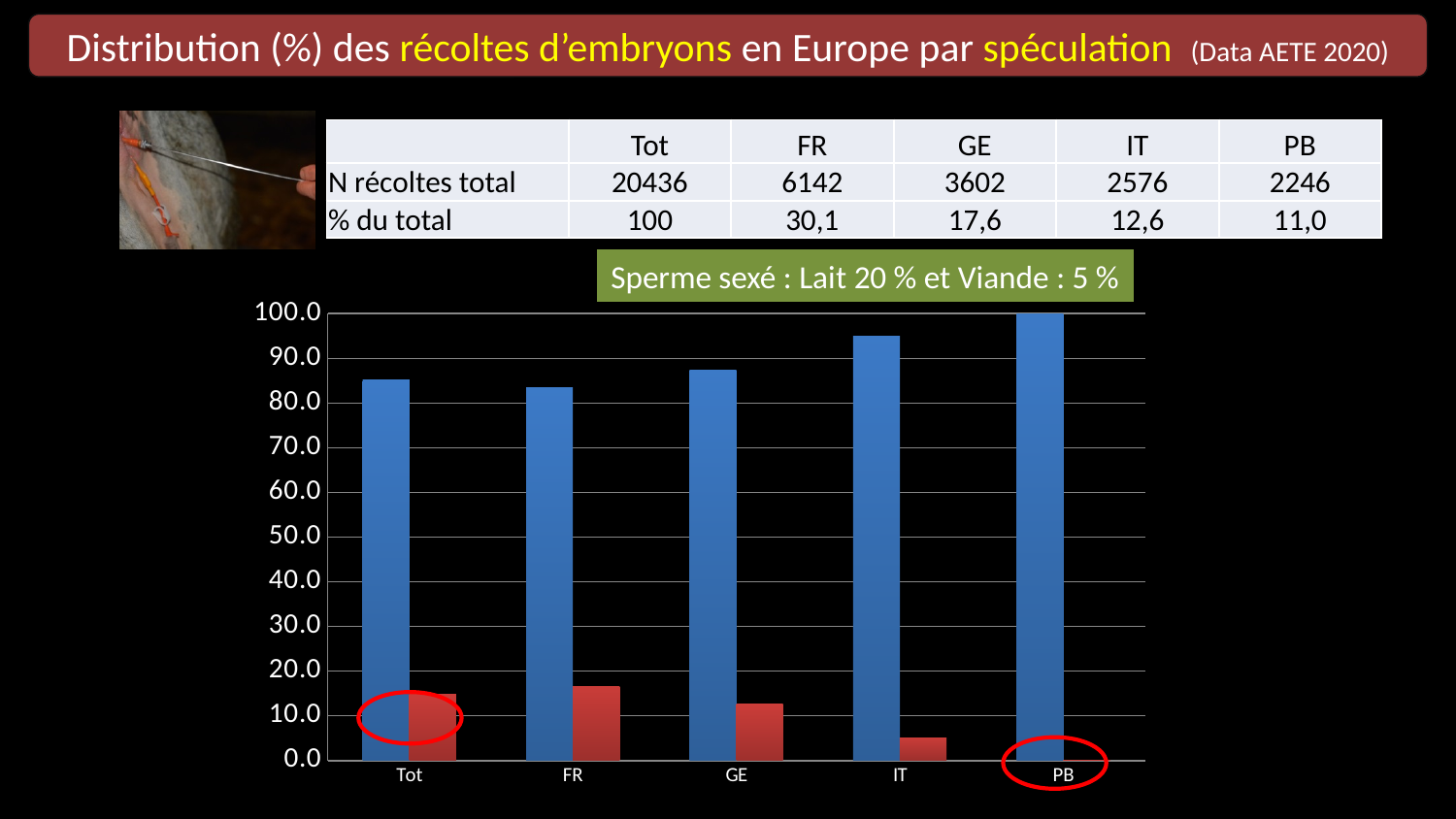
Is the red bar for FR greater or less than 20.0? less What is the highest value shown on the y axis of the chart? 100.0 Which is larger, the blue bar for IT or the blue bar for GE? IT How many categories are shown on the x axis of the chart? 5 Do the red bars rise or fall from FR to PB along the x axis? fall Which category has the tallest blue bar? PB What kind of chart is shown on the slide? bar chart Is the blue bar for IT greater or less than 90.0? greater Is the blue bar for Tot greater or less than 80.0? greater Which is larger, the red bar for FR or the red bar for IT? FR